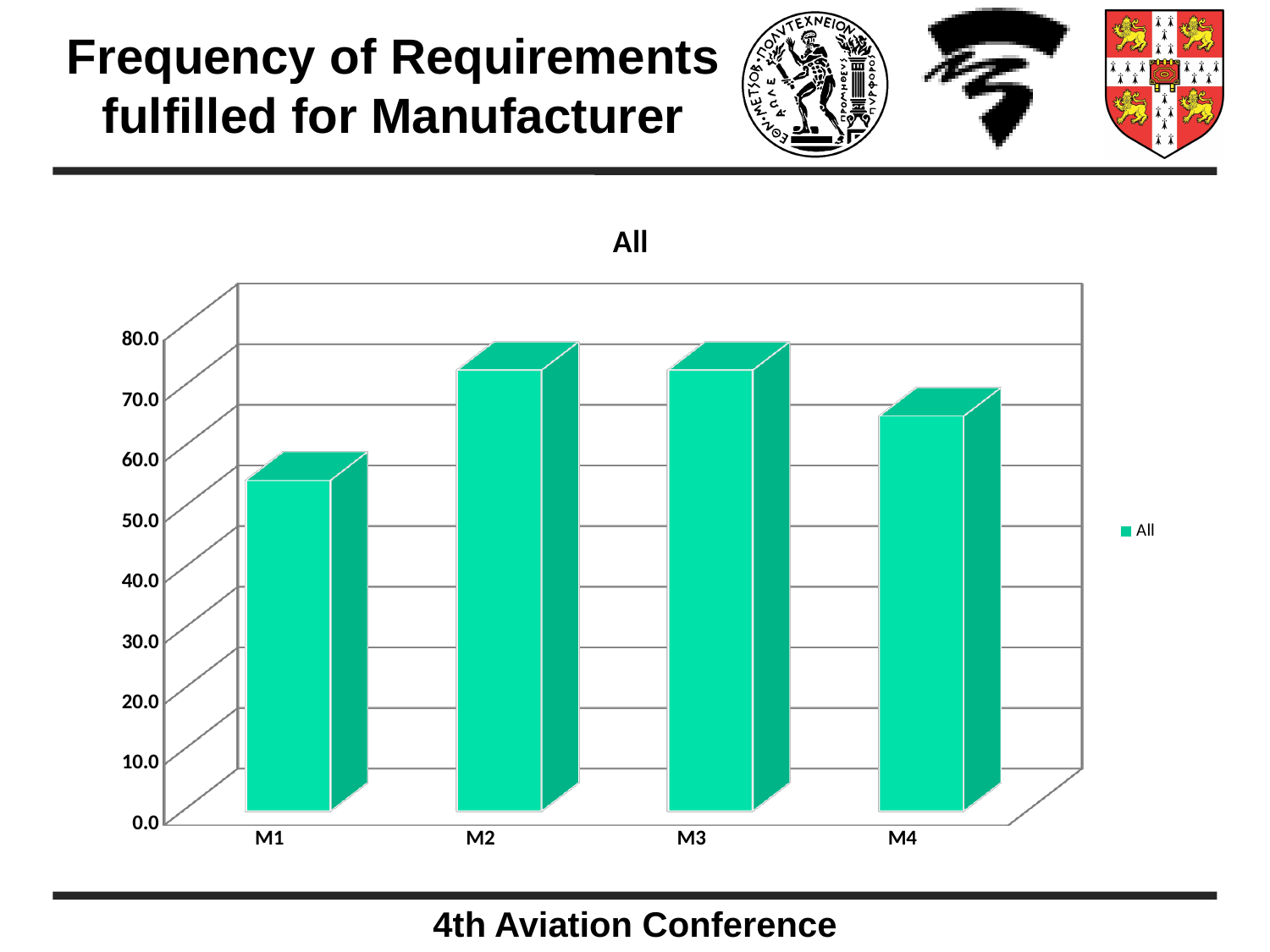
Is the value for M3 greater or less than 80? less Which category has the lowest value in the chart? M1 What is the name of the series shown in the legend? All How many series does the chart's legend list? 1 Is the value for M4 greater or less than 60? greater How many categories are plotted on the x axis of the chart? 4 What is the title of the chart? All Which has the larger value, M1 or M4? M4 Is the value for M1 greater or less than 60? less What kind of chart is shown on the slide? bar chart